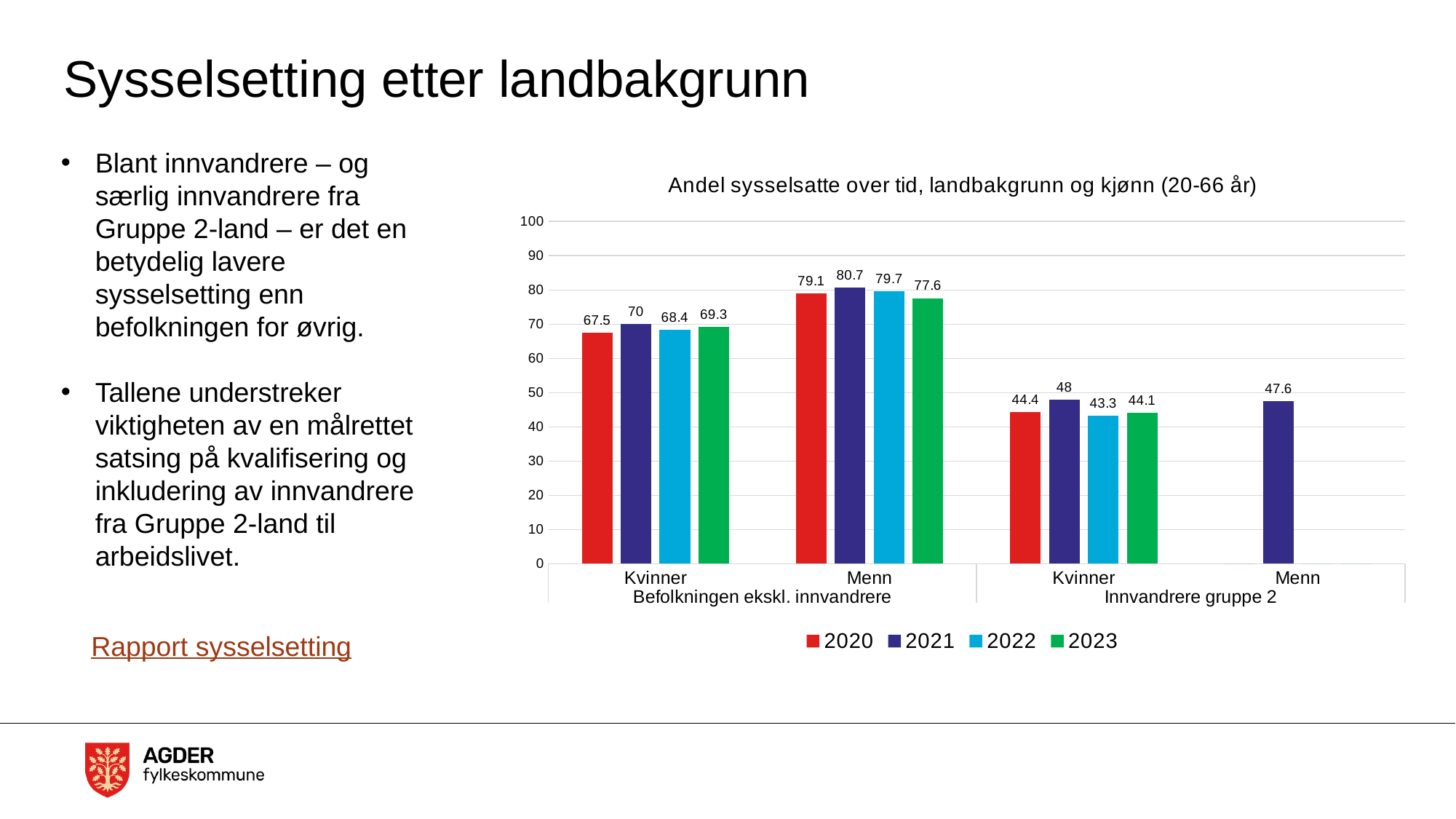
What is the value for 2021 for Menn in the Innvandrere gruppe 2 group? 47.6 Which year has the lowest value for Menn in the Befolkningen ekskl. innvandrere group? 2023 What is the value for 2022 for Kvinner in the Innvandrere gruppe 2 group? 43.3 Is the 2022 value for Menn in the Befolkningen ekskl. innvandrere group greater or less than 70? greater What is the title of the chart? Andel sysselsatte over tid, landbakgrunn og kjønn (20-66 år) How many series does the legend list? 4 What is the difference between the 2023 values for Menn and Kvinner in the Befolkningen ekskl. innvandrere group? 8.3 What kind of chart is shown on the slide? Bar chart What is the value for 2020 for Kvinner in the Befolkningen ekskl. innvandrere group? 67.5 Which is larger: the 2020 value for Kvinner in Befolkningen ekskl. innvandrere or the 2020 value for Kvinner in Innvandrere gruppe 2? Befolkningen ekskl. innvandrere Which year has the highest value for Kvinner in the Innvandrere gruppe 2 group? 2021 What is the value for 2021 for Menn in the Befolkningen ekskl. innvandrere group? 80.7